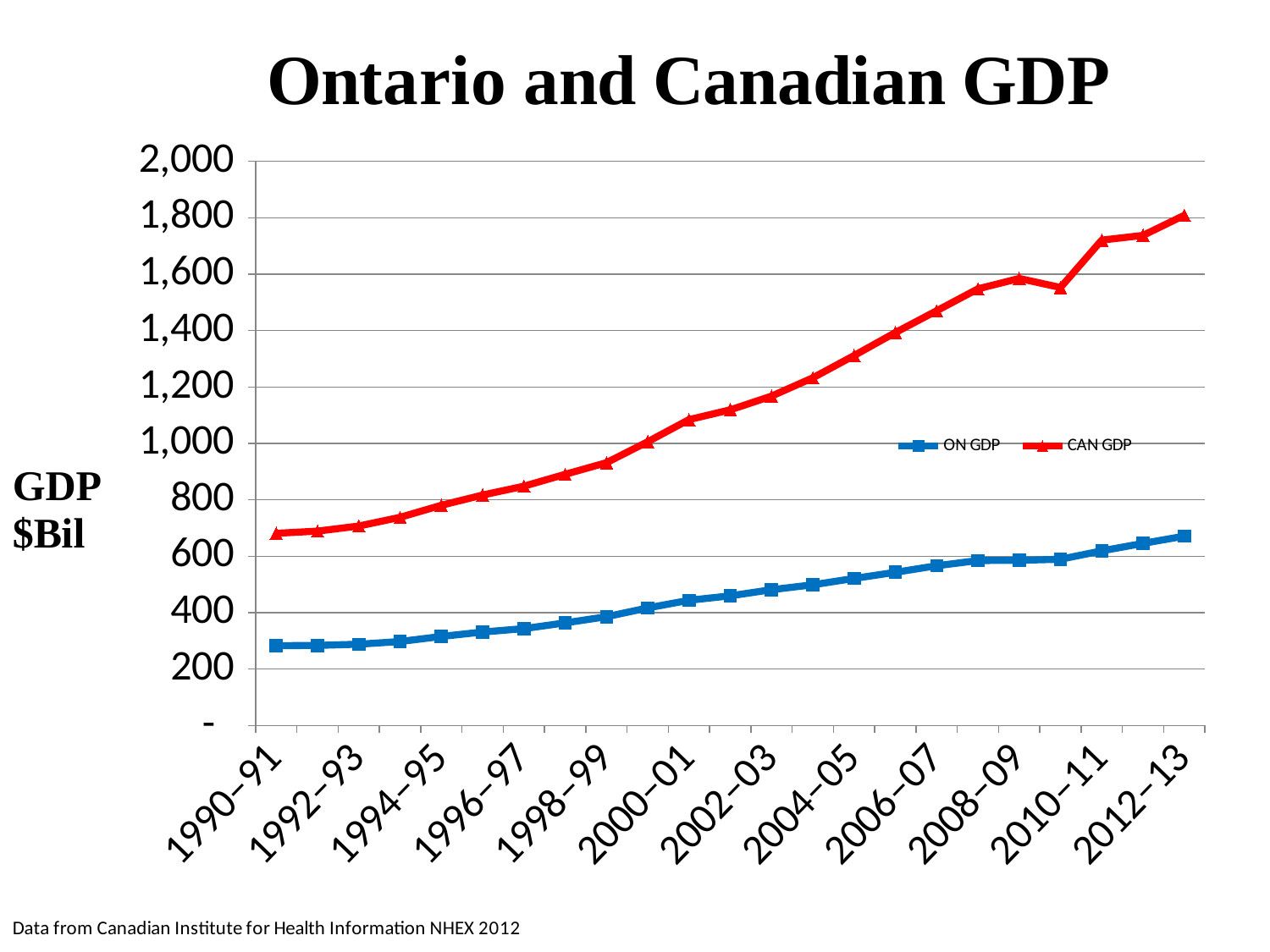
Does the ON GDP series generally rise or fall from 1990–91 to 2012–13? rise Is the ON GDP value for 2012–13 greater or less than 600? greater Which colour is used for the CAN GDP series? red How many series does the legend list? 2 Which series has the larger value in 2004–05, ON GDP or CAN GDP? CAN GDP Is the CAN GDP value for 2008–09 greater or less than 1,400? greater What kind of chart is shown on the slide? line chart Is the CAN GDP value for 1990–91 greater or less than 800? less What is the title of the chart? Ontario and Canadian GDP How many year labels are shown on the x axis? 12 Does the CAN GDP series generally rise or fall from 1990–91 to 2012–13? rise